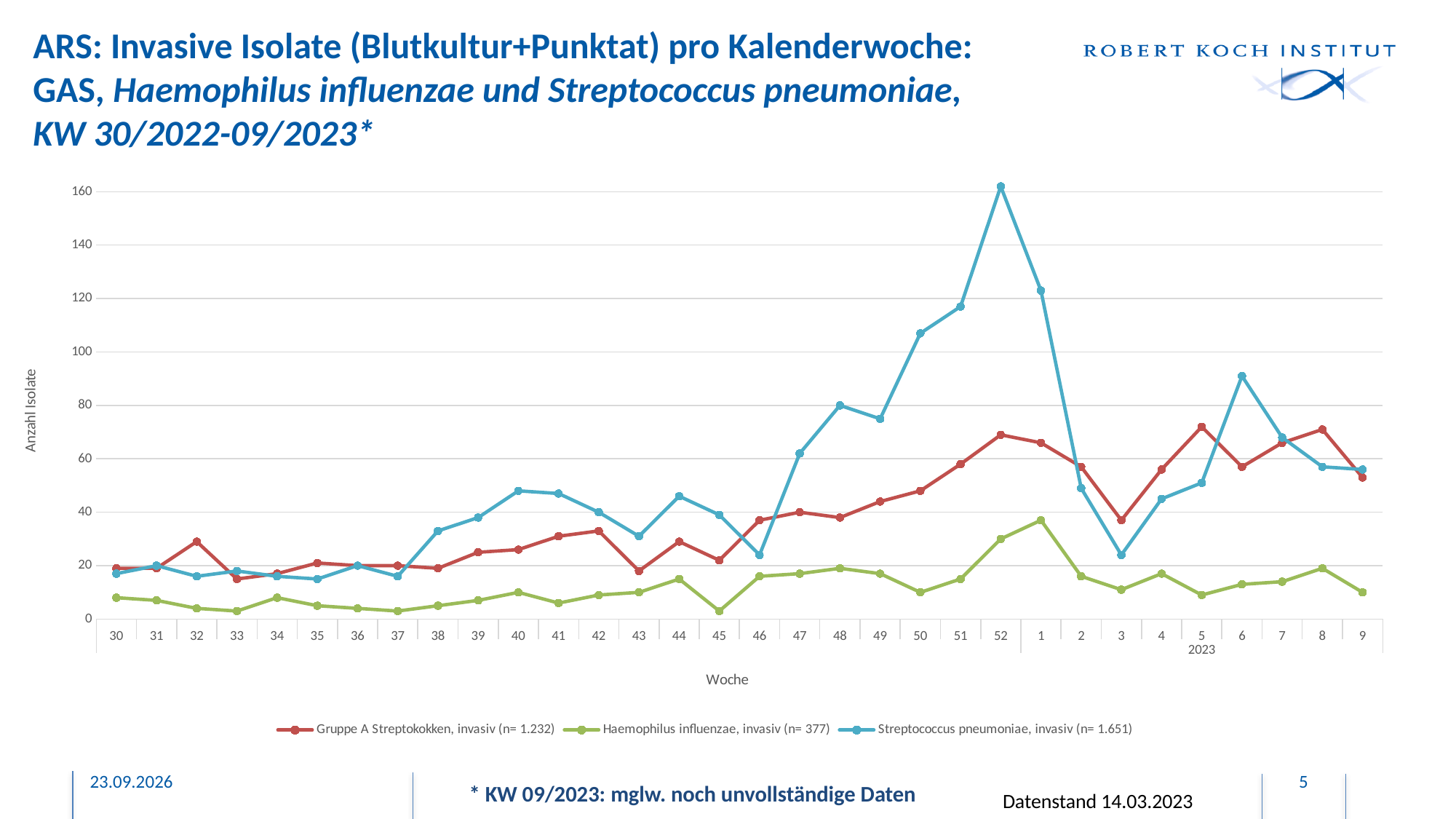
What kind of chart is shown on the slide? line chart How many calendar weeks are plotted along the x axis? 32 In week 5, which series has the larger value: Gruppe A Streptokokken or Streptococcus pneumoniae? Gruppe A Streptokokken Is the value for Gruppe A Streptokokken in week 52 greater or less than 60? greater Does the Streptococcus pneumoniae series rise or fall from week 46 to week 52? rise How many series does the legend list? 3 Is the value for Streptococcus pneumoniae in week 3 greater or less than 40? less In which week does the Streptococcus pneumoniae series reach its highest value? 52 What is the label of the y axis? Anzahl Isolate Is the value for Streptococcus pneumoniae in week 52 greater or less than 140? greater In which week does the Haemophilus influenzae series reach its highest value? 1